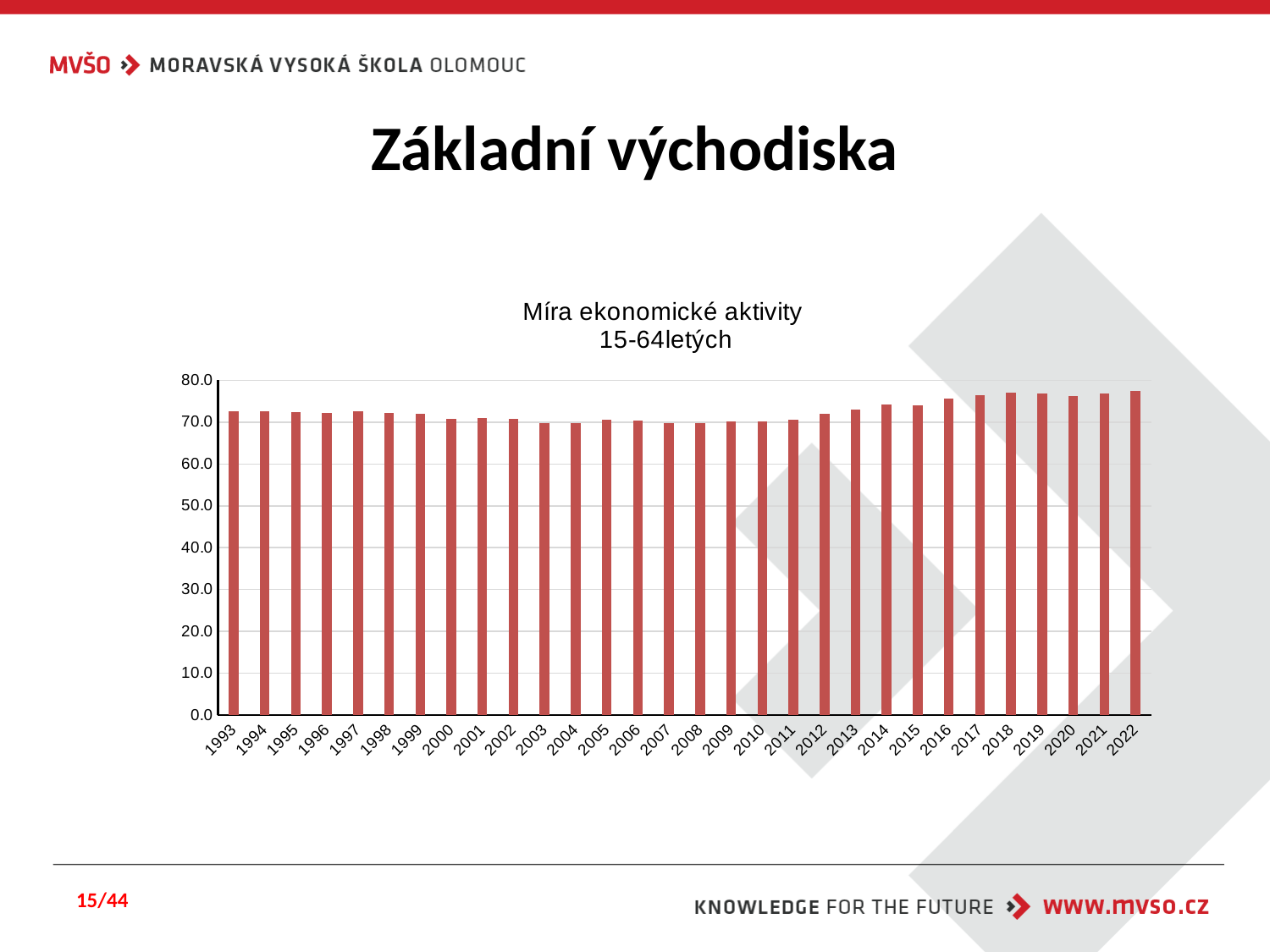
What is the title of the chart? Míra ekonomické aktivity 15-64letých Do the values generally rise or fall from 1993 to 2003? fall Is the value for 1993 greater or less than 70? greater How many years (bars) are plotted on the chart? 30 What is the first year shown on the x axis? 1993 Is the value for 2022 greater or less than 80? less Is the value for 2003 greater or less than 60? greater Do the values generally rise or fall from 2013 to 2022? rise Which is larger, the value for 2022 or the value for 2007? 2022 Which is larger, the value for 2008 or the value for 2017? 2017 What kind of chart is shown on the slide? bar chart